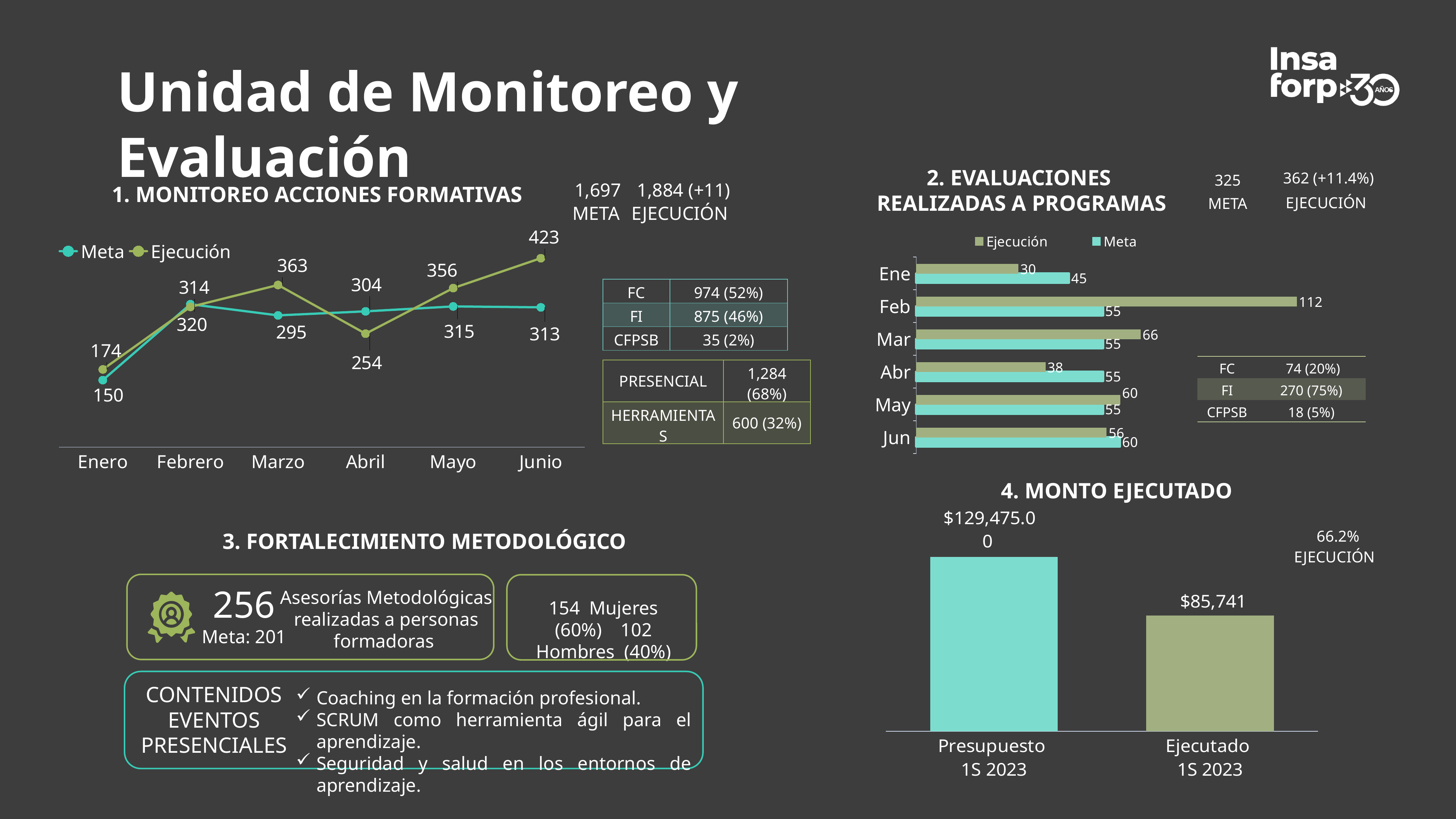
What kind of chart is '1. MONITOREO ACCIONES FORMATIVAS'? Line chart In the chart '4. MONTO EJECUTADO', what is the value for Ejecutado 1S 2023? $85,741 In the chart '1. MONITOREO ACCIONES FORMATIVAS', how many series does the legend list? 2 In the chart '1. MONITOREO ACCIONES FORMATIVAS', what is the Ejecución value for Junio? 423 How many months are shown in the chart '2. EVALUACIONES REALIZADAS A PROGRAMAS'? 6 In the chart '1. MONITOREO ACCIONES FORMATIVAS', what is the Meta value for Enero? 150 What kind of chart is '4. MONTO EJECUTADO'? Bar chart In the chart '2. EVALUACIONES REALIZADAS A PROGRAMAS', is the Ejecución value or the Meta value larger for Abr? Meta In the chart '2. EVALUACIONES REALIZADAS A PROGRAMAS', which month has the lowest Ejecución value? Ene In the chart '1. MONITOREO ACCIONES FORMATIVAS', what is the difference between Ejecución and Meta in Marzo? 68 In the chart '2. EVALUACIONES REALIZADAS A PROGRAMAS', what is the Ejecución value for Feb? 112 In the chart '1. MONITOREO ACCIONES FORMATIVAS', which month has the highest Ejecución value? Junio